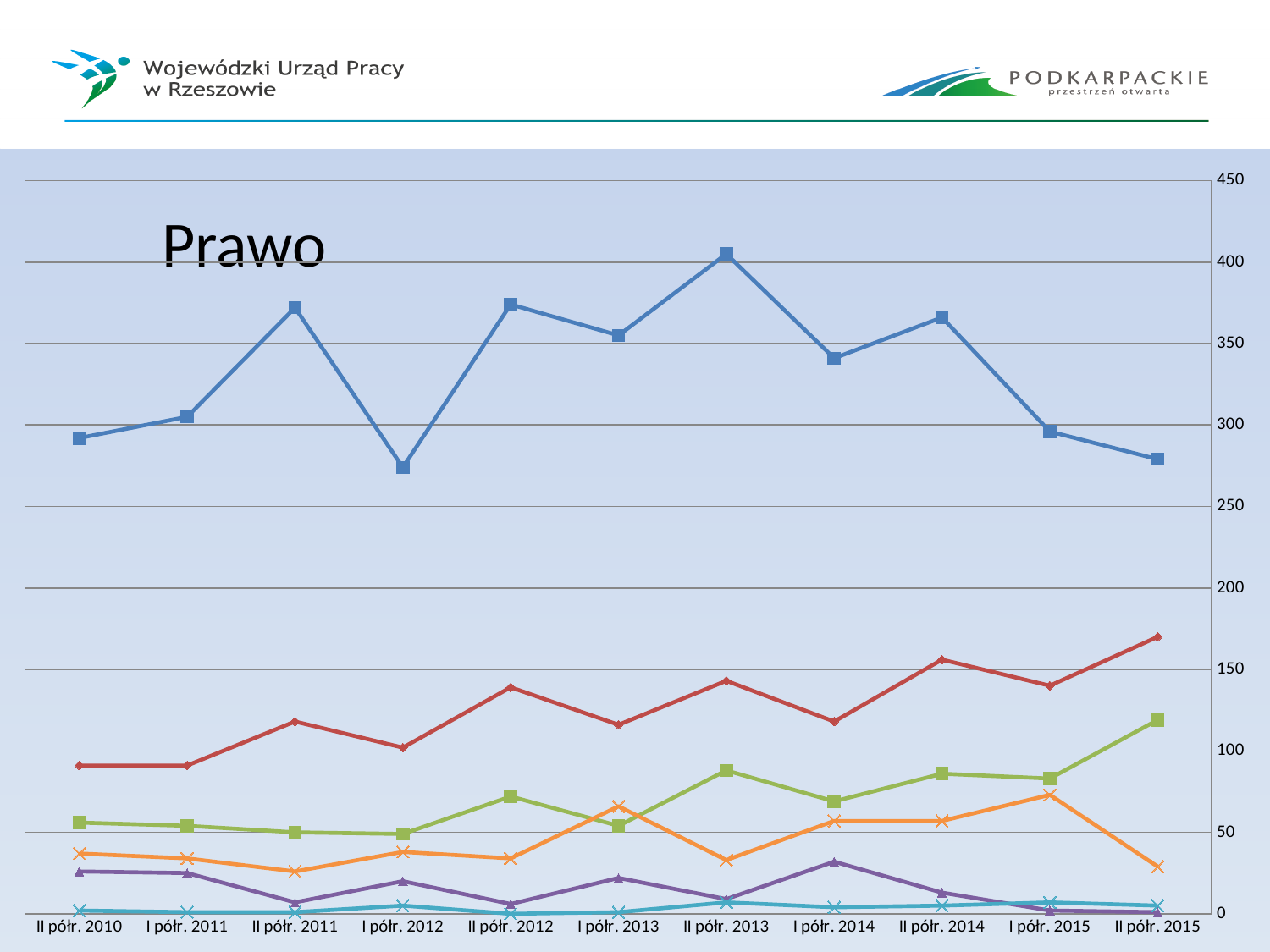
How many categories (half-year periods) are shown on the x axis? 11 Is the value of the green line for II półr. 2015 greater or less than 100? greater What is the title of the chart? Prawo Is the value of the red line for II półr. 2015 greater or less than 150? greater Which line has the larger value for II półr. 2013, the blue line or the red line? the blue line How many lines are plotted on the chart? 6 Which period has the highest value on the blue line? II półr. 2013 Is the value of the blue line for I półr. 2012 greater or less than 300? less What kind of chart is shown on the slide? line chart Which period has the highest value on the red line? II półr. 2015